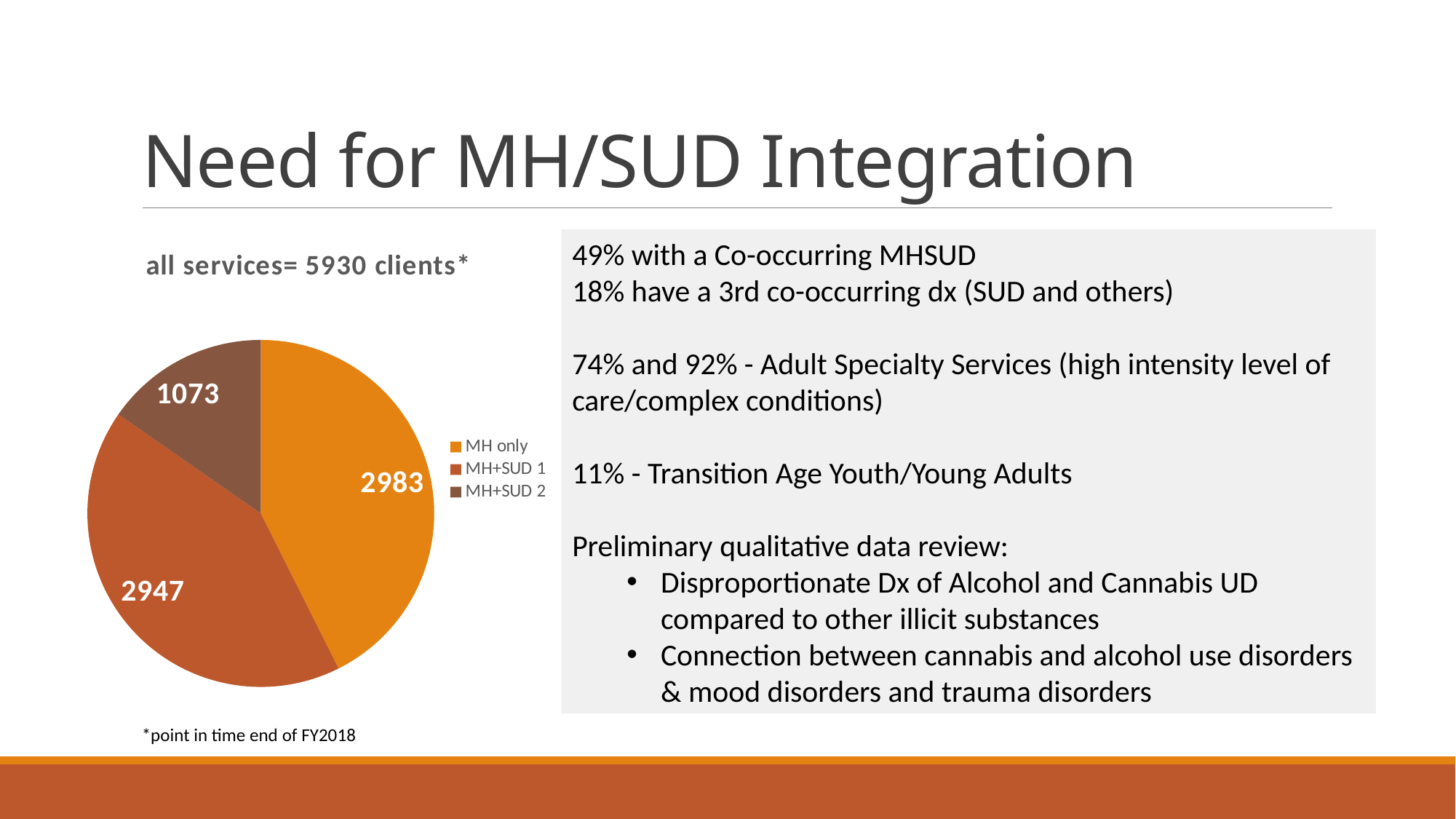
What type of chart is shown on the slide? Pie chart How many entries does the legend of the pie chart list? 3 What is the title of the pie chart? all services= 5930 clients* What is the difference between the MH only value and the MH+SUD 1 value? 36 Which category has the largest slice in the pie chart? MH only What is the difference between the MH+SUD 1 value and the MH+SUD 2 value? 1874 How many slices does the pie chart have? 3 Which is larger, the MH+SUD 1 value or the MH+SUD 2 value? MH+SUD 1 What is the value for the MH+SUD 1 slice? 2947 What is the value for the MH+SUD 2 slice? 1073 What is the value for the MH only slice? 2983 Which category has the smallest slice in the pie chart? MH+SUD 2